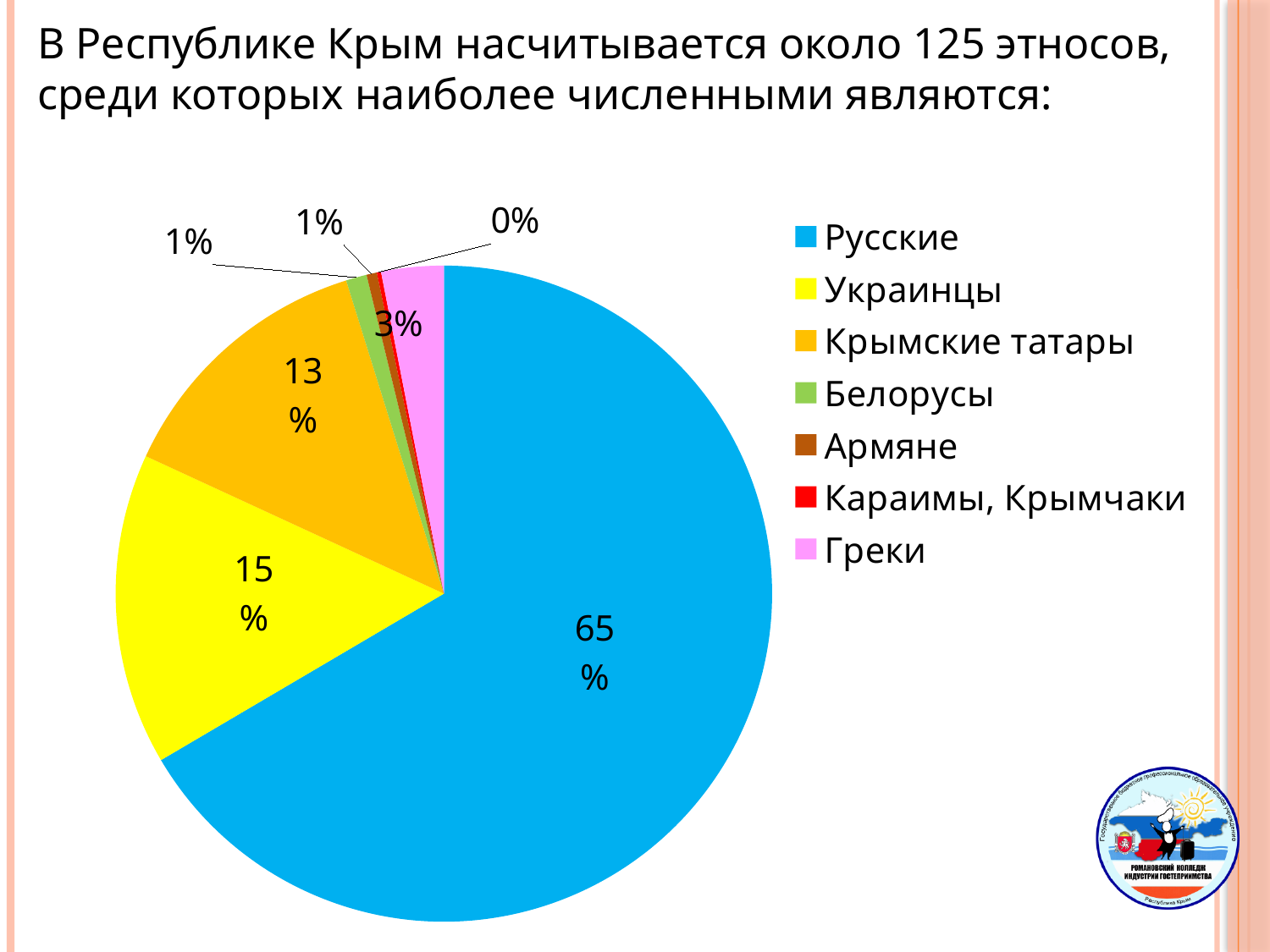
What kind of chart is shown on the slide? pie chart What colour is the slice for Русские? blue What share of the pie is labelled for Крымские татары? 13% Which group has the largest slice of the pie? Русские Which is larger, the share of Греки or the share of Белорусы? Греки What is the difference between the shares of Украинцы and Крымские татары? 2% What share of the pie is labelled for Караимы, Крымчаки? 0% What share of the pie is labelled for Греки? 3% What share of the pie is labelled for Русские? 65% Which group has the smallest slice of the pie? Караимы, Крымчаки How many groups does the legend list? 7 What share of the pie is labelled for Украинцы? 15%